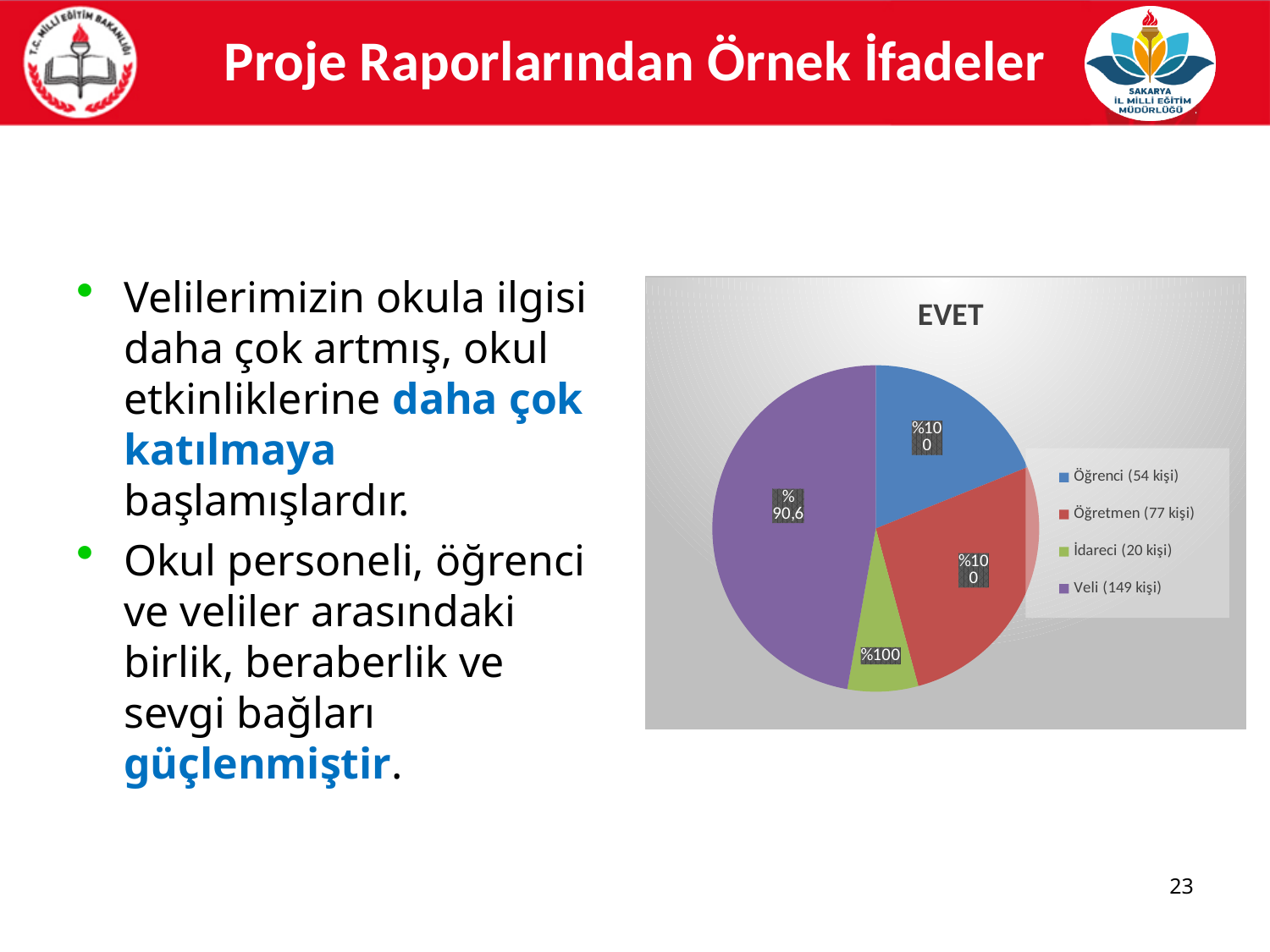
What data label is printed on the Öğrenci slice of the pie chart? %100 How many entries does the legend of the pie chart list? 4 Which group takes up the smallest slice of the pie chart? İdareci (20 kişi) What is the title of the pie chart? EVET What data label is printed on the Veli slice of the pie chart? %90,6 What is the difference between the number of people in the Veli group and the Öğretmen group, as given in the legend? 72 kişi Which group takes up the largest slice of the pie chart? Veli (149 kişi) According to the legend, how many people are in the İdareci group? 20 kişi According to the legend, how many people are in the Öğretmen group? 77 kişi How many slices does the pie chart have? 4 What kind of chart is shown on the slide? pie chart Which slice is larger in the pie chart, Veli or Öğrenci? Veli